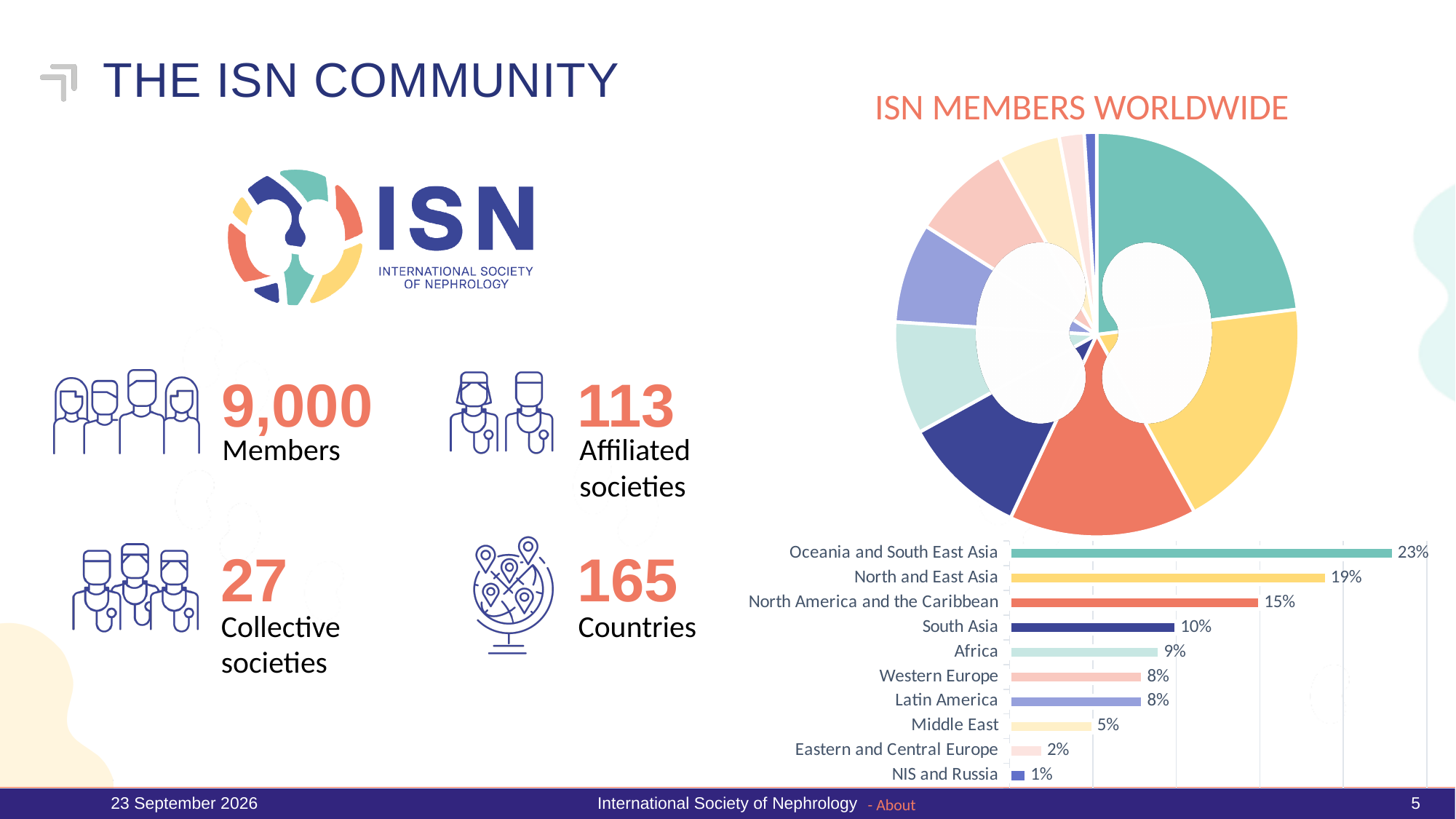
In the bar chart at the bottom right, which is larger, the value for South Asia or the value for Africa? South Asia What is the title of the pie chart on the right side of the slide? ISN MEMBERS WORLDWIDE How many regions are listed in the bar chart at the bottom right? 10 In the bar chart at the bottom right, what is the value for North America and the Caribbean? 15% In the bar chart at the bottom right, what is the value for Oceania and South East Asia? 23% In the bar chart at the bottom right, which two regions both have a value of 8%? Western Europe and Latin America What kind of chart is the chart at the bottom right of the slide, below the pie? bar chart In the bar chart at the bottom right, what is the difference between the values for Oceania and South East Asia and North and East Asia? 4 percentage points What kind of chart is the chart titled 'ISN MEMBERS WORLDWIDE'? pie chart In the bar chart at the bottom right, which region has the lowest value? NIS and Russia In the bar chart at the bottom right, what is the value for Middle East? 5% In the bar chart at the bottom right, which region has the highest value? Oceania and South East Asia